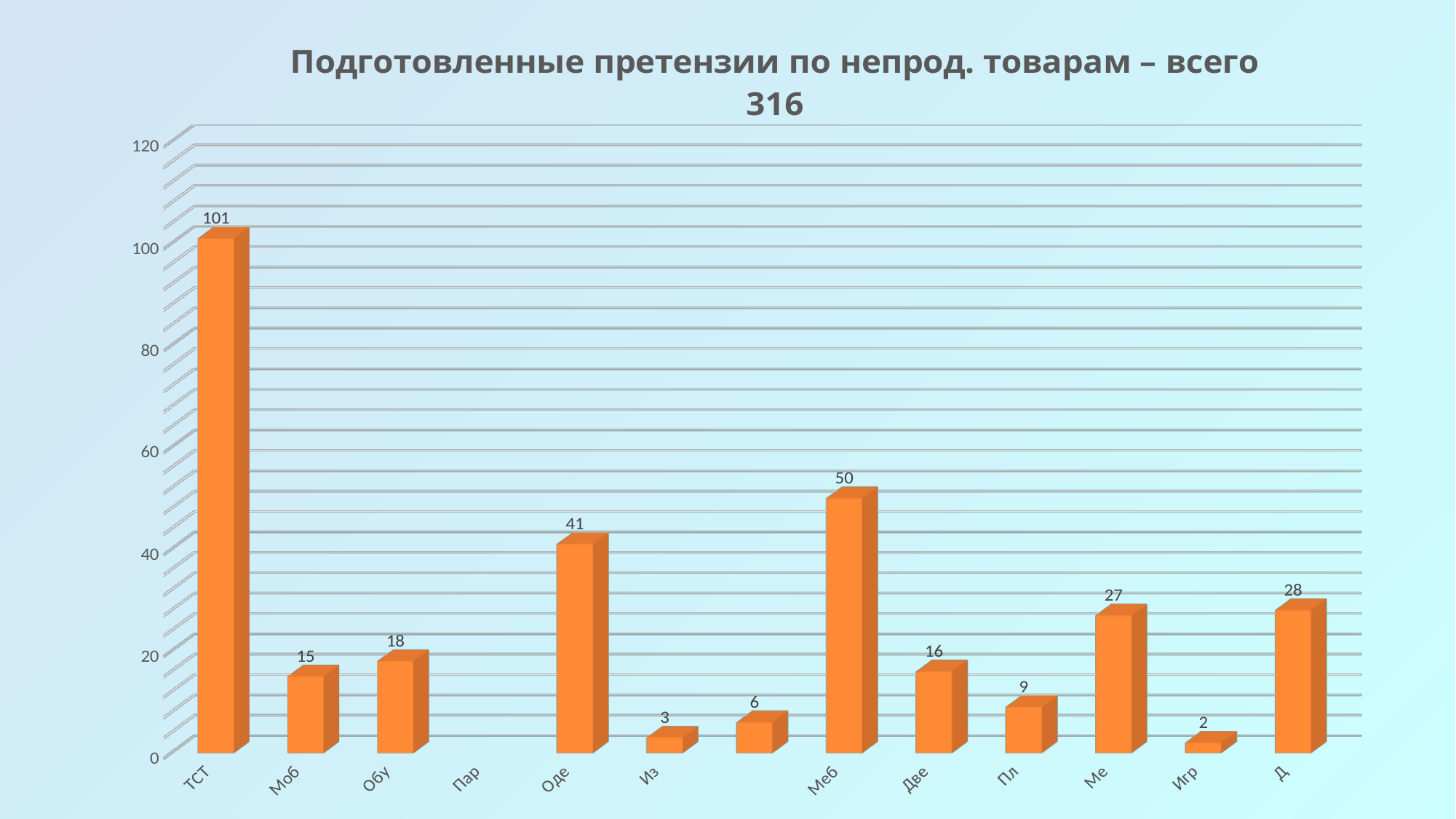
What total is stated in the chart title? 316 What is the value for ТСТ? 101 What is the difference between the values for Д and Ме? 1 What is the difference between the values for ТСТ and Меб? 51 Is the value for Оде greater or less than 40? greater What is the value for Меб? 50 What is the value for Игр? 2 Which is larger, the value for Обу or the value for Моб? Обу Which category has the highest value? ТСТ Which labelled category with a bar has the lowest value? Игр What is the value for Оде? 41 What kind of chart is shown on the slide? bar chart